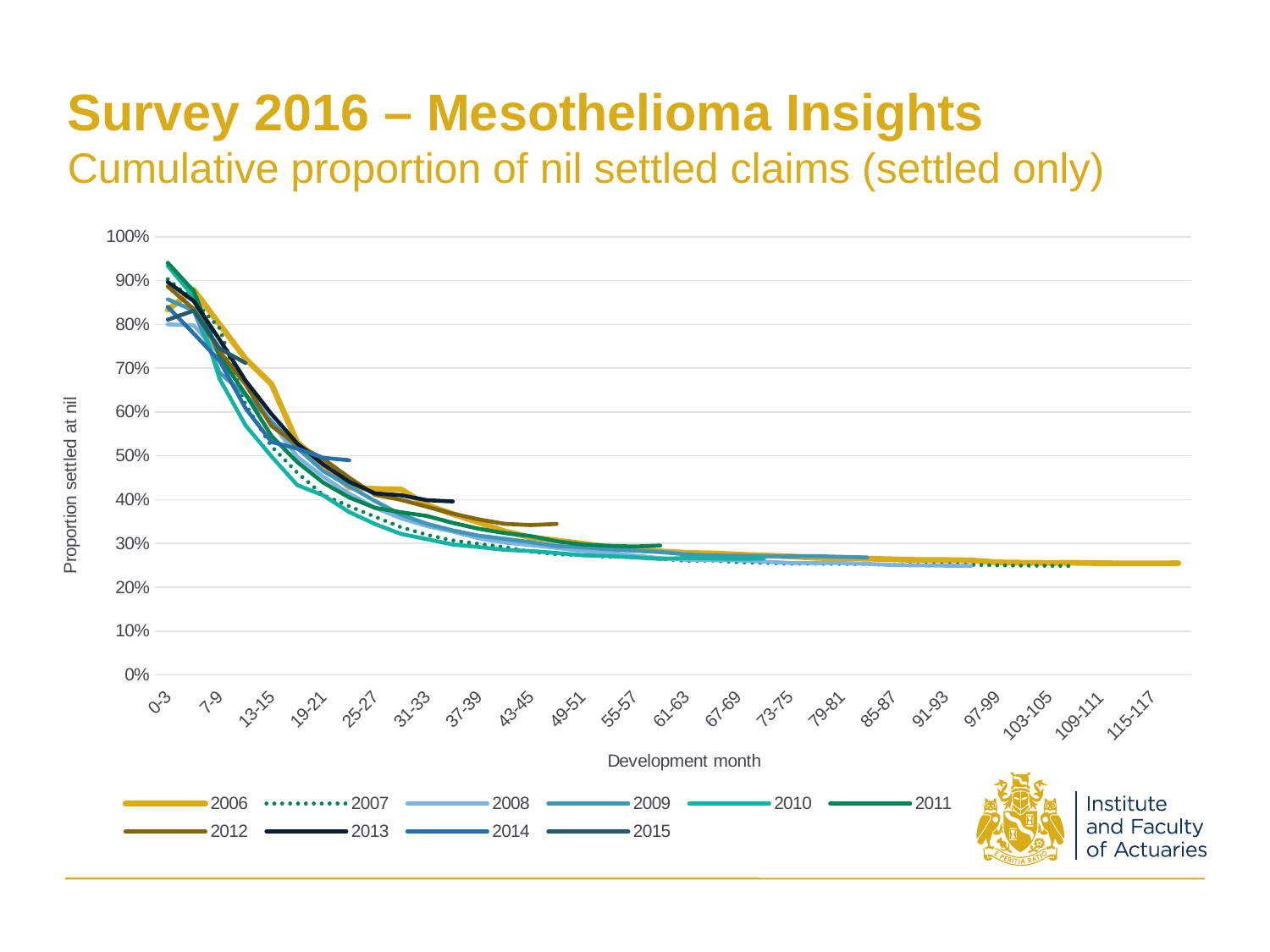
Is the value for 2006 at development month 115-117 greater or less than 30%? less Is the value for 2006 at development month 13-15 greater or less than 60%? greater At development month 13-15, which is larger, the value for 2006 or the value for 2010? 2006 Which series starts highest at development month 0-3? 2011 Which series is drawn with a dotted line in the legend? 2007 Is the value for 2010 at development month 0-3 greater or less than 90%? greater Do the values generally rise or fall as development month increases? Fall Which series extends furthest along the x axis, reaching development month 115-117? 2006 What kind of chart is shown on the slide? Line chart What is the label of the vertical axis? Proportion settled at nil How many series does the legend list? 10